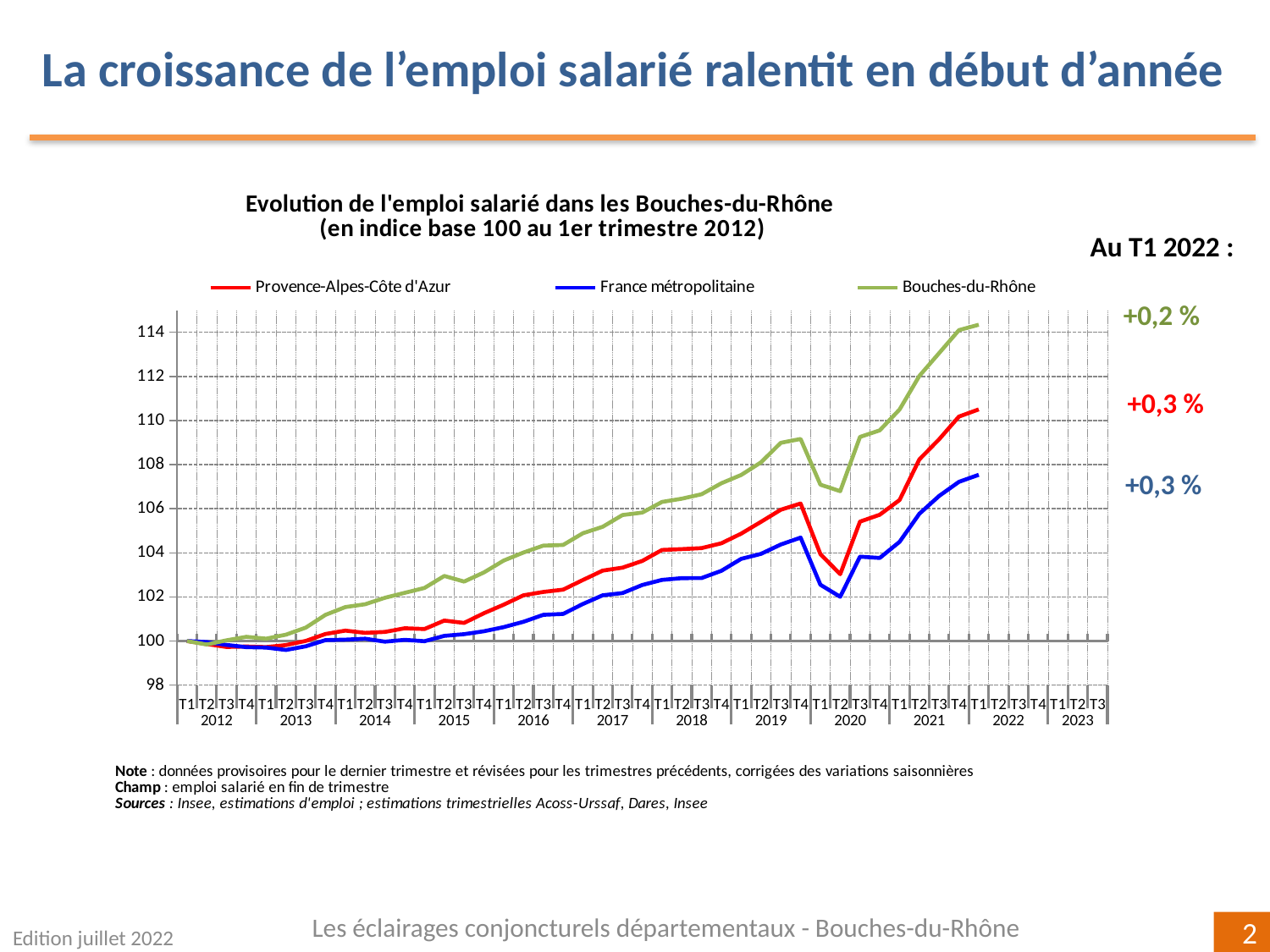
What growth rate is annotated for Bouches-du-Rhône at T1 2022? +0,2 % Is the value for Provence-Alpes-Côte d'Azur at T1 2022 greater or less than 108? greater Overall, do the values for France métropolitaine rise or fall from T1 2012 to T1 2022? rise Which series has the lowest value at T1 2022? France métropolitaine What kind of chart is shown on the slide? line chart Is the value for France métropolitaine at T2 2020 greater or less than 104? less Which series is drawn in green in the legend? Bouches-du-Rhône Do the values for Bouches-du-Rhône rise or fall between T4 2019 and T2 2020? fall Is the value for Bouches-du-Rhône at T1 2022 greater or less than 112? greater How many series does the legend list? 3 What is the base value of the index, according to the chart title? 100 au 1er trimestre 2012 Which series has the highest value at T1 2022? Bouches-du-Rhône